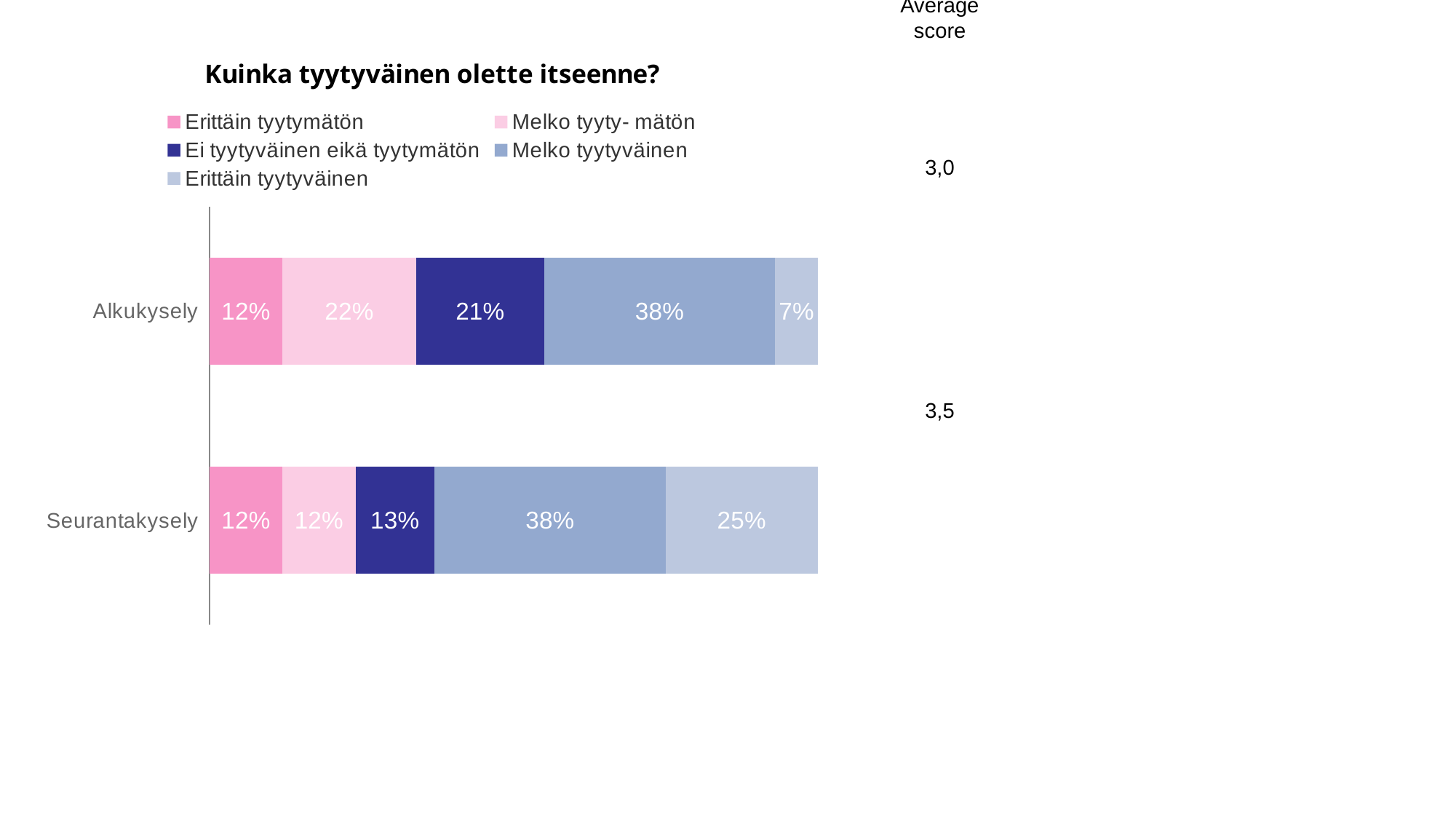
What kind of chart is shown on the slide? Stacked bar chart What is the difference between the Erittäin tyytyväinen values for Seurantakysely and Alkukysely? 18% What is the value for Erittäin tyytyväinen in the Seurantakysely bar? 25% What is the value for Erittäin tyytyväinen in the Alkukysely bar? 7% Which segment is the smallest in the Alkukysely bar? Erittäin tyytyväinen What is the value for Ei tyytyväinen eikä tyytymätön in the Seurantakysely bar? 13% What is the average score shown for Seurantakysely? 3,5 What is the value for Melko tyytymätön in the Alkukysely bar? 22% How many series does the legend list? 5 Which segment is the largest in the Alkukysely bar? Melko tyytyväinen Which is larger: Melko tyytymätön for Alkukysely or Melko tyytymätön for Seurantakysely? Alkukysely How many categories (bars) are shown in the chart? 2